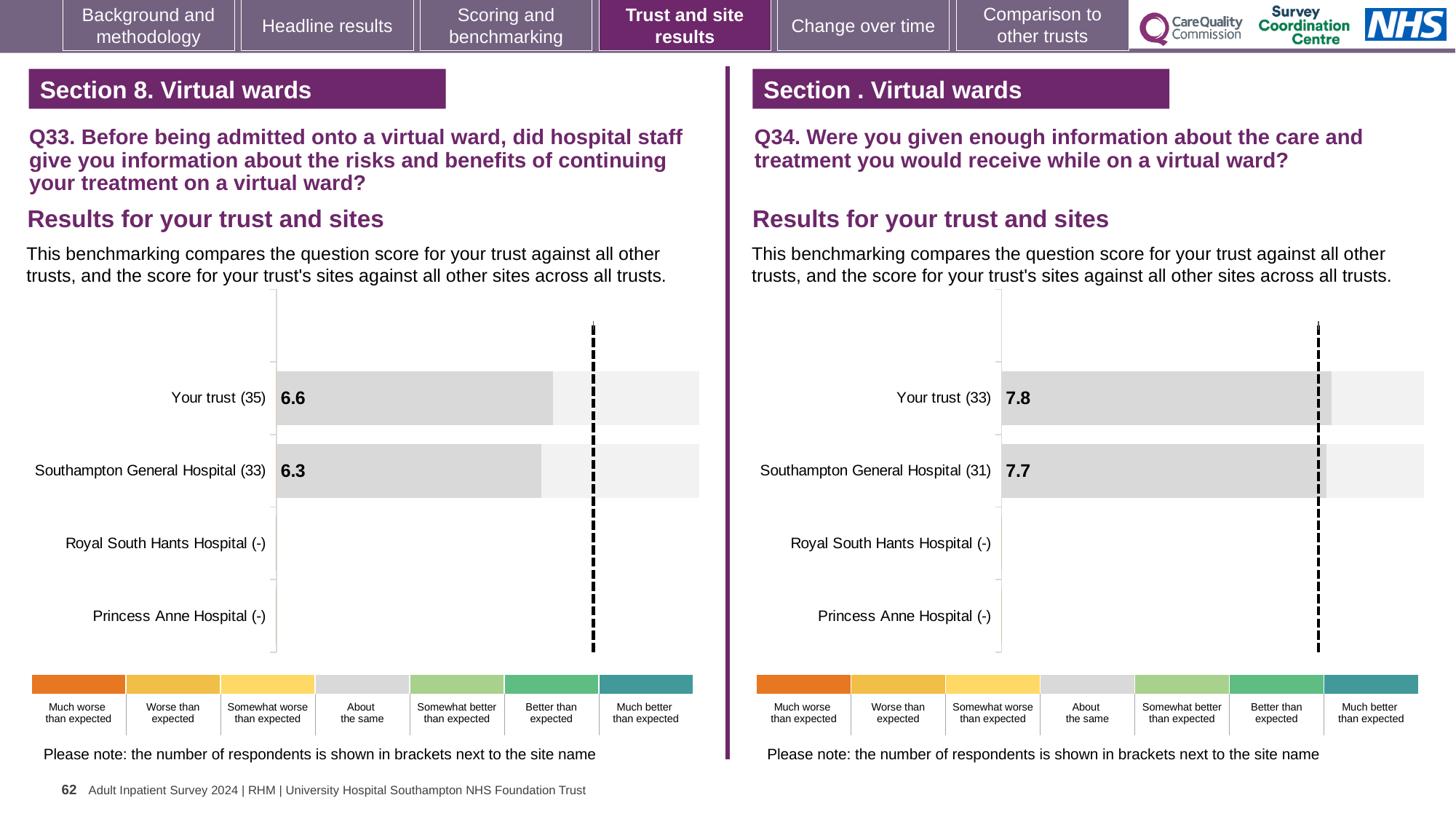
In the Q33 chart on the left, which has the higher score, Your trust or Southampton General Hospital? Your trust In the Q33 chart on the left, what is the score for Your trust? 6.6 How many site or trust categories are listed on the y axis of the Q33 chart on the left? 4 In the Q34 chart on the right, what is the score for Southampton General Hospital? 7.7 How many benchmark categories are shown in the colour key below the Q33 chart on the left? 7 What kind of chart is used for the Q34 results on the right? Bar chart In the Q34 chart on the right, how many respondents are shown in brackets for Southampton General Hospital? 31 In the Q34 chart on the right, what is the score for Your trust? 7.8 In the Q33 chart on the left, how many respondents are shown in brackets for Your trust? 35 In the Q33 chart on the left, what is the difference between the score for Your trust and the score for Southampton General Hospital? 0.3 In the Q34 chart on the right, what is the difference between the score for Your trust and the score for Southampton General Hospital? 0.1 In the Q33 chart on the left, what is the score for Southampton General Hospital? 6.3